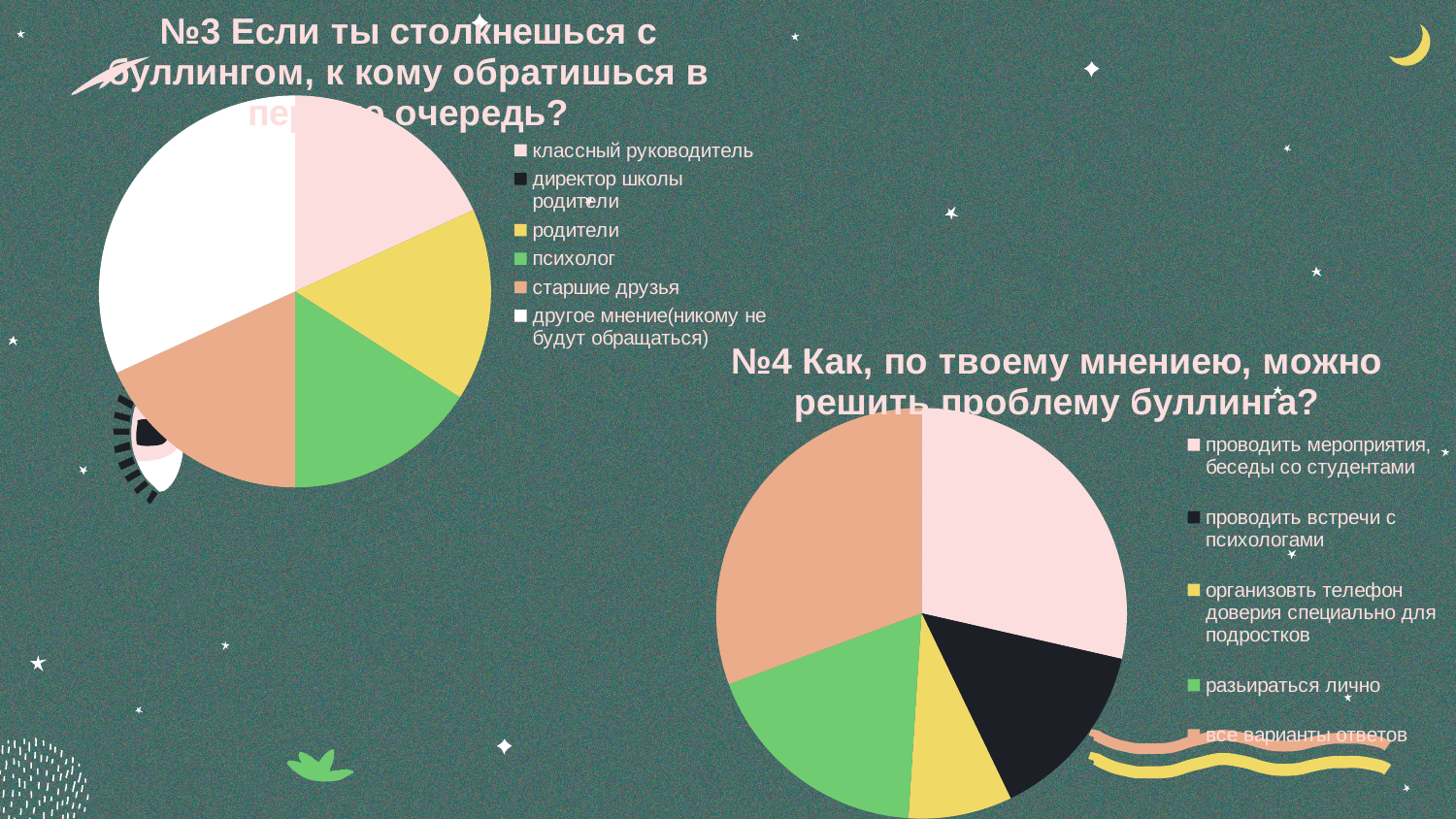
In the chart titled "№3 Если ты столкнешься с буллингом...", which slice is larger: классный руководитель or другое мнение(никому не будут обращаться)? другое мнение(никому не будут обращаться) In the chart titled "№4 Как, по твоему мнениею, можно решить проблему буллинга?", how many entries does the legend list? 5 In the chart titled "№3 Если ты столкнешься с буллингом...", what colour is the slice for старшие друзья? orange What kind of chart is the chart titled "№3 Если ты столкнешься с буллингом, к кому обратишься в первую очередь?"? pie chart In the chart titled "№3 Если ты столкнешься с буллингом...", how many entries does the legend list? 6 In the chart titled "№4 Как, по твоему мнениею, можно решить проблему буллинга?", what colour is the slice for проводить встречи с психологами? black In the chart titled "№4 Как, по твоему мнениею, можно решить проблему буллинга?", which category has the smallest slice? организовть телефон доверия специально для подростков In the chart titled "№3 Если ты столкнешься с буллингом...", which category has the largest slice? другое мнение(никому не будут обращаться) In the chart titled "№4 Как, по твоему мнениею, можно решить проблему буллинга?", which slice is larger: разьираться лично or проводить встречи с психологами? разьираться лично What kind of chart is the chart titled "№4 Как, по твоему мнениею, можно решить проблему буллинга?"? pie chart